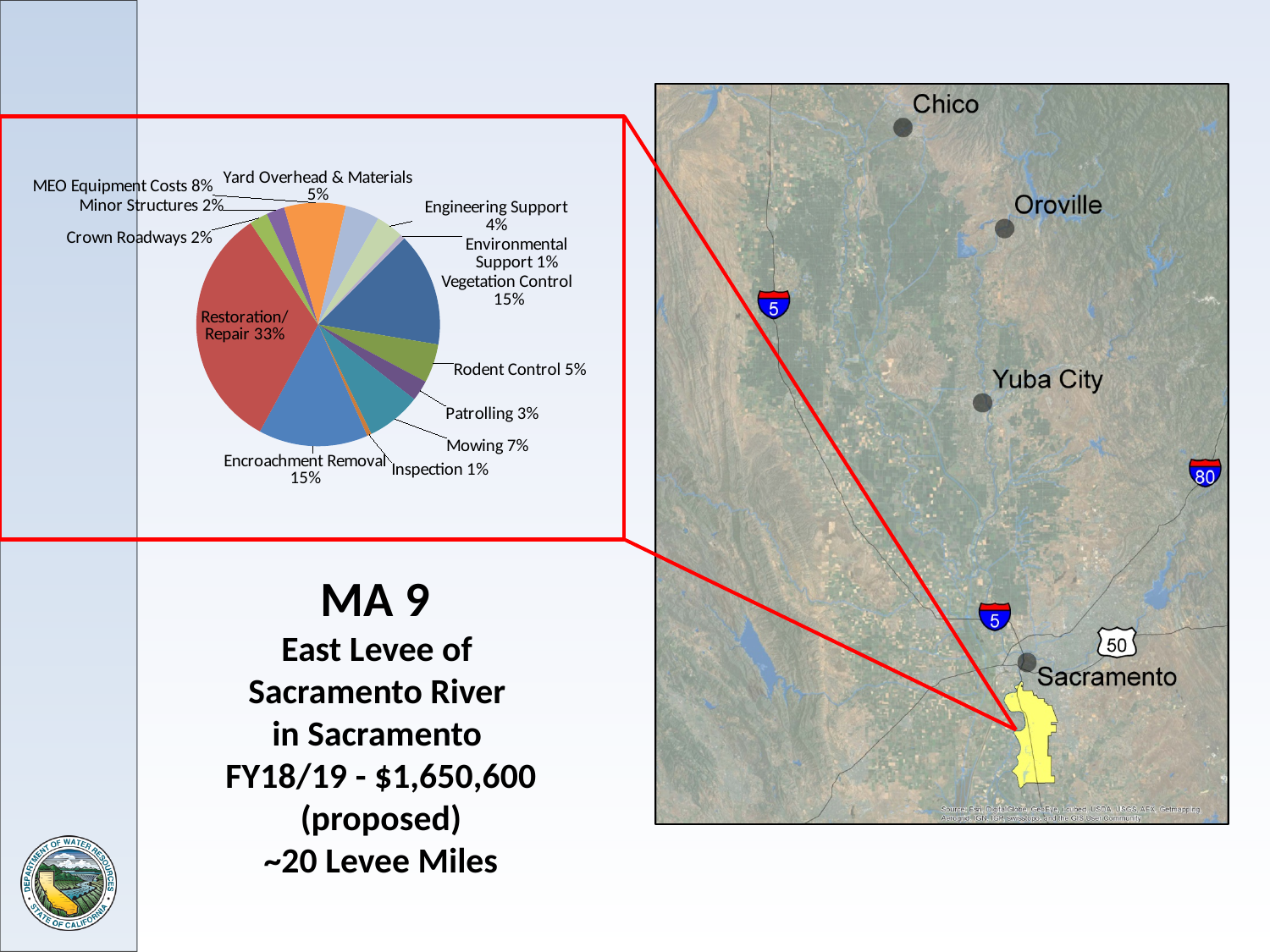
How many categories are shown in the pie chart? 13 What is the difference between the shares for Mowing and Engineering Support? 3% Which is larger, the share for Rodent Control or the share for Patrolling? Rodent Control What is the value shown for Yard Overhead & Materials? 5% Which category has the largest share of the pie? Restoration/Repair What is the value shown for Vegetation Control? 15% What is the value shown for MEO Equipment Costs? 8% What type of chart is shown on the slide? pie chart What is the difference between the shares for Restoration/Repair and Encroachment Removal? 18% What share of the pie does Restoration/Repair account for? 33% What is the value shown for Mowing? 7% Which is larger, the share for MEO Equipment Costs or the share for Crown Roadways? MEO Equipment Costs